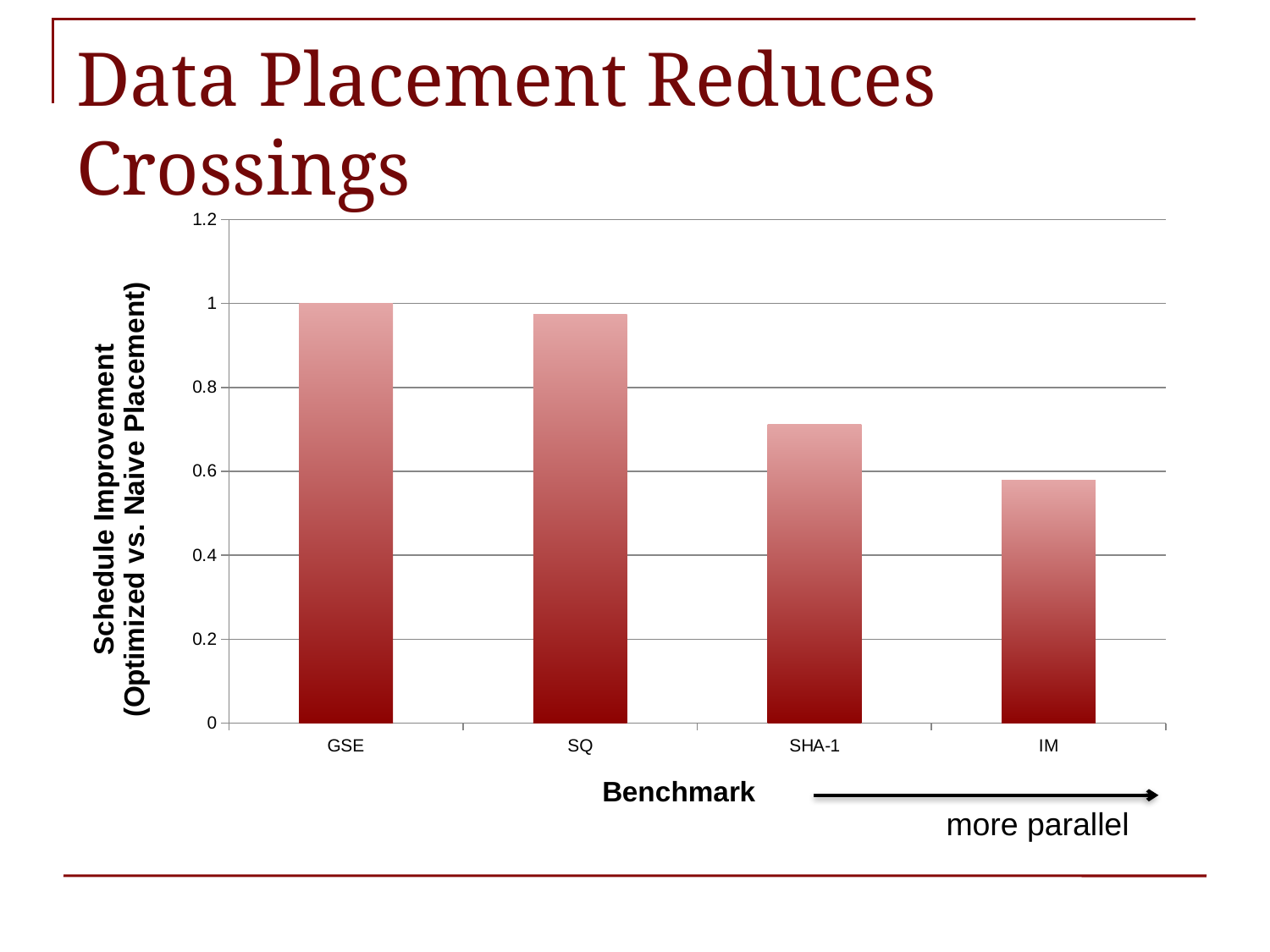
Is the value for IM greater or less than 0.4? greater What is the title of the x axis? Benchmark What kind of chart is shown on the slide? bar chart How many benchmarks are plotted on the x axis? 4 What is the schedule improvement value for GSE? 1 Is the value for SQ greater or less than 0.8? greater Which has a larger value, SQ or SHA-1? SQ Which benchmark has the highest schedule improvement value? GSE Is the value for SHA-1 greater or less than 0.6? greater Do the values rise or fall moving from GSE to IM along the x axis? fall Which benchmark has the lowest schedule improvement value? IM